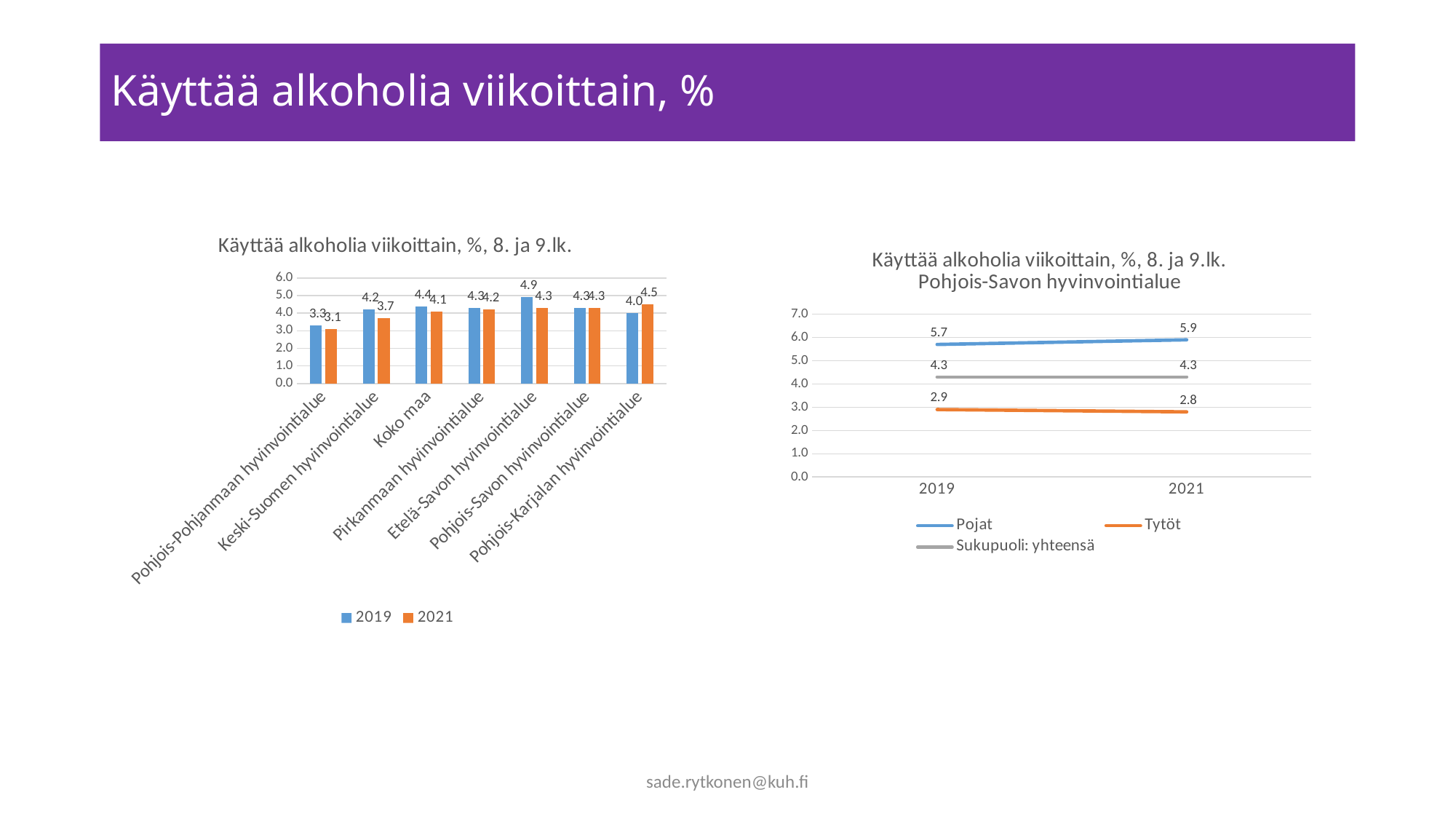
What kind of chart is the left chart? Bar chart In the left chart, what is the 2019 value for Etelä-Savon hyvinvointialue? 4.9 In the left chart, what is the difference between the 2019 and 2021 values for Etelä-Savon hyvinvointialue? 0.6 In the left chart, which category has the highest 2019 value? Etelä-Savon hyvinvointialue How many categories are shown on the x axis of the left chart? 7 In the left chart, which category has the lowest 2021 value? Pohjois-Pohjanmaan hyvinvointialue In the right chart, what is the value for Pojat in 2021? 5.9 How many series does the legend of the right chart list? 3 In the left chart, which is larger for Pohjois-Karjalan hyvinvointialue, the 2019 value or the 2021 value? 2021 In the left chart, what is the 2021 value for Keski-Suomen hyvinvointialue? 3.7 In the right chart, what is the value for Tytöt in 2019? 2.9 In the right chart, does the Pojat line rise or fall from 2019 to 2021? Rise